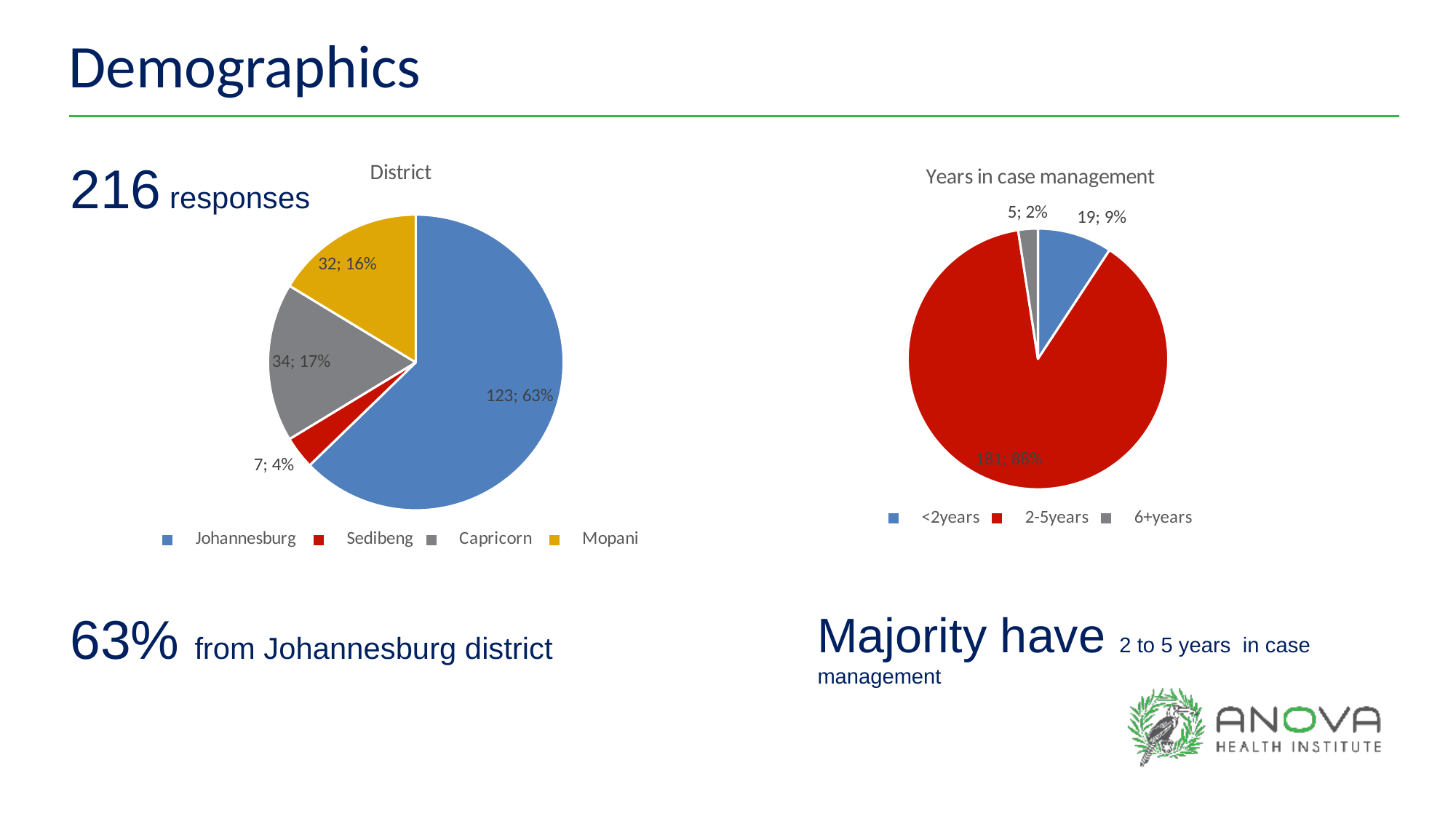
In the Years in case management chart, which is larger, <2years or 6+years? <2years In the District chart, what share of the pie does Capricorn represent? 17% In the Years in case management chart, what share of the pie does <2years represent? 9% In the District chart, which district has the smallest slice? Sedibeng In the Years in case management chart, which category has the smallest slice? 6+years In the Years in case management chart, what is the value for 2-5years? 181 In the District chart, what is the difference between the Johannesburg and Mopani values? 91 In the District chart, what is the value for Johannesburg? 123 In the District chart, how many districts are shown? 4 In the District chart, which district has the largest slice? Johannesburg In the Years in case management chart, what colour is the 2-5years slice? Red What type of chart is the District chart? Pie chart